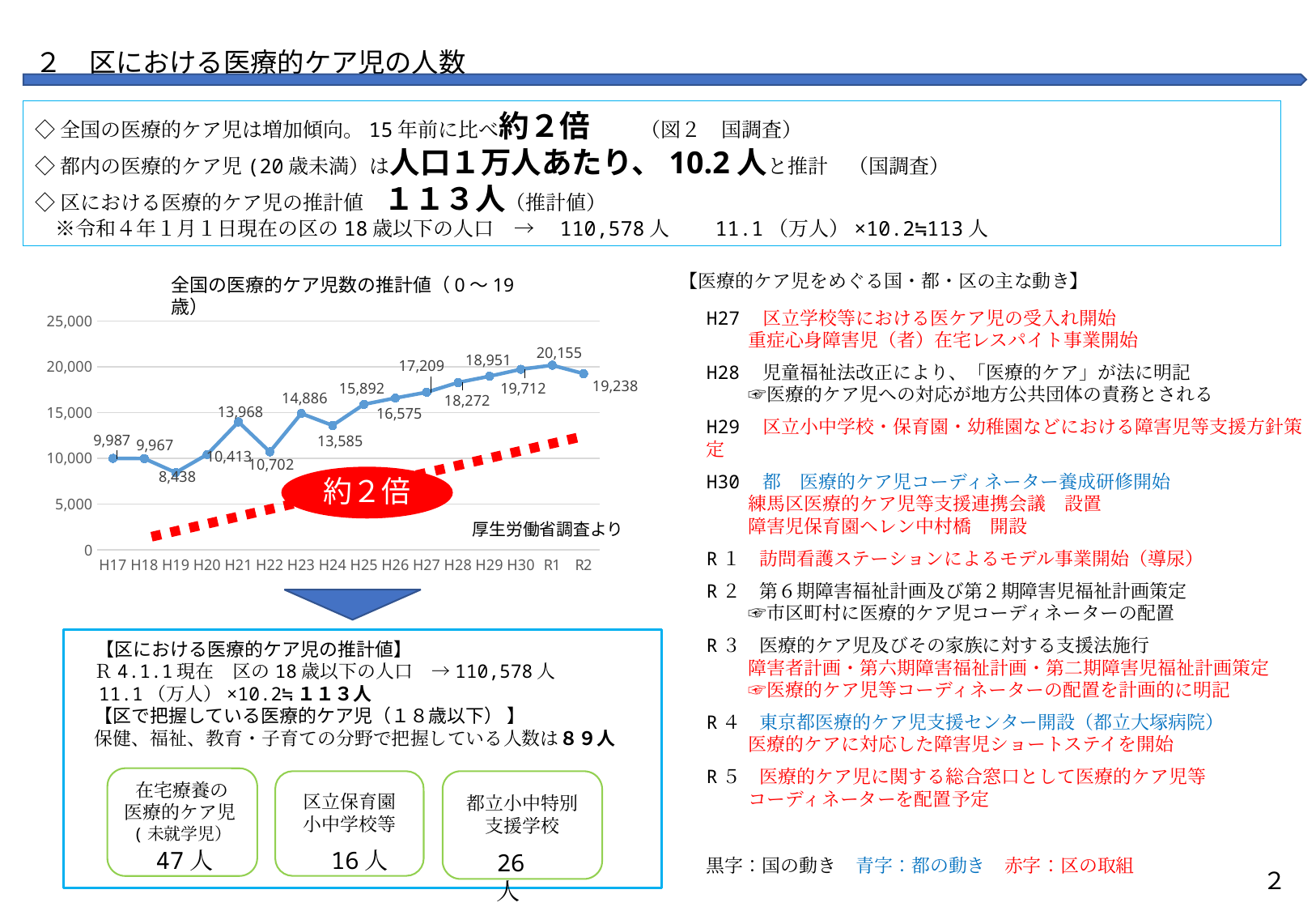
What type of chart is shown on the slide? line chart Overall, do the values rise or fall from H17 to R2? rise What is the value for R1 in the chart? 20,155 Which year has the lowest value in the chart? H19 What is the difference between the values for H21 and H22? 3,266 What is the difference between the values for R1 and R2? 917 How many data points are plotted in the chart? 16 Which year has the highest value in the chart? R1 Which is larger, the value for H23 or the value for H24? H23 What is the value for H17 in the chart 全国の医療的ケア児数の推計値（0～19歳）? 9,987 What is the title of the chart? 全国の医療的ケア児数の推計値（0～19歳） What is the value for H24 in the chart? 13,585